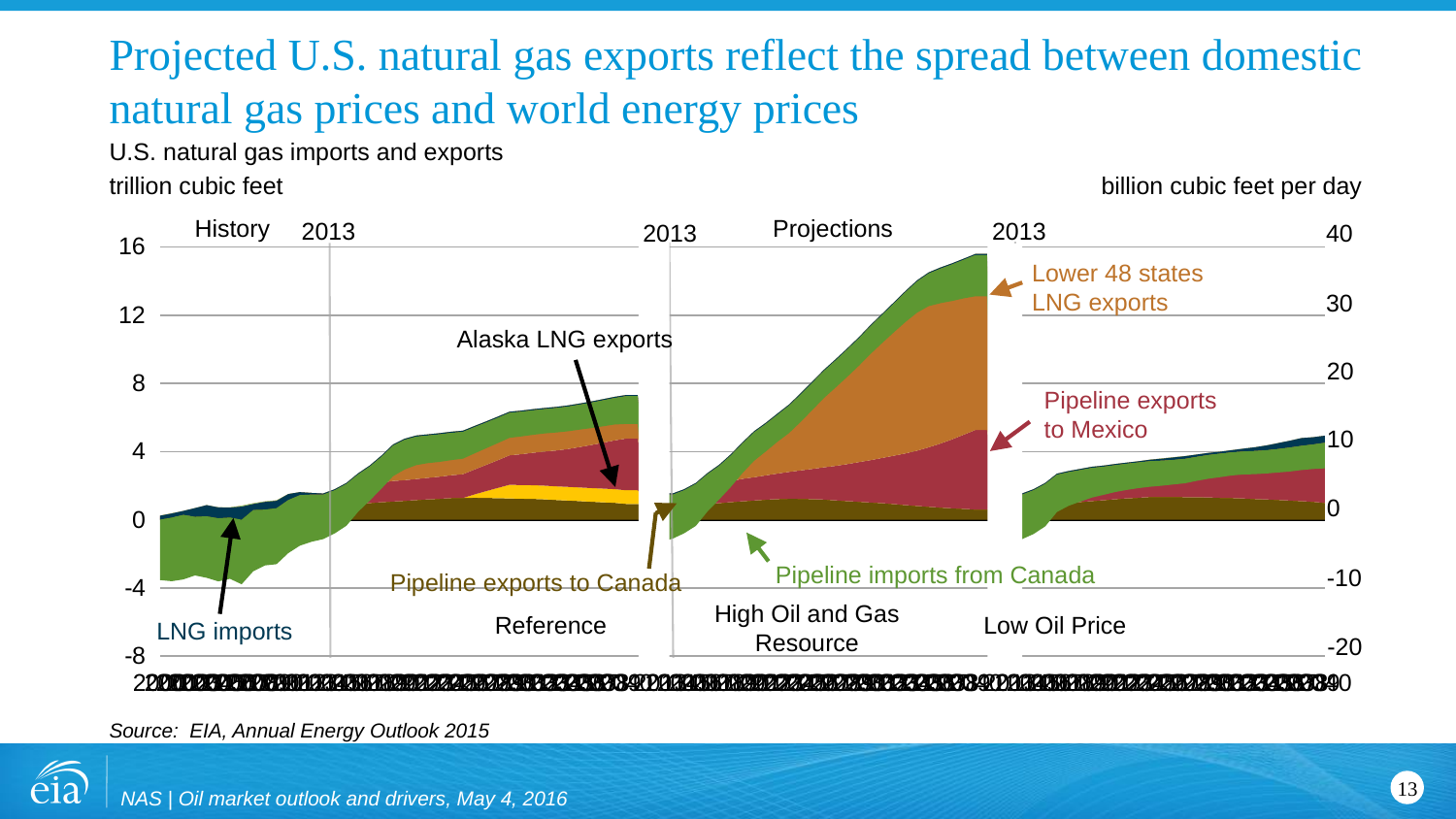
Is the total at the end of the Low Oil Price scenario greater or less than 4 trillion cubic feet? greater Which projection scenario reaches the lowest total natural gas exports by the end of the projection period? Low Oil Price What kind of chart is shown on the slide? Stacked area chart Which component is shown below zero in the History portion of the chart? LNG imports and Pipeline imports from Canada Do total net exports rise or fall over time in the High Oil and Gas Resource scenario? rise Which component makes up the largest share of exports in the High Oil and Gas Resource scenario at its peak? Lower 48 states LNG exports How many projection scenarios are shown in the chart? 3 Is the total at the end of the Reference scenario greater or less than 8 trillion cubic feet? less What unit is shown on the right vertical axis of the chart? billion cubic feet per day Which projection scenario reaches the highest total natural gas exports? High Oil and Gas Resource What unit is shown on the left vertical axis of the chart? trillion cubic feet Is the peak total in the High Oil and Gas Resource scenario greater or less than 12 trillion cubic feet? greater